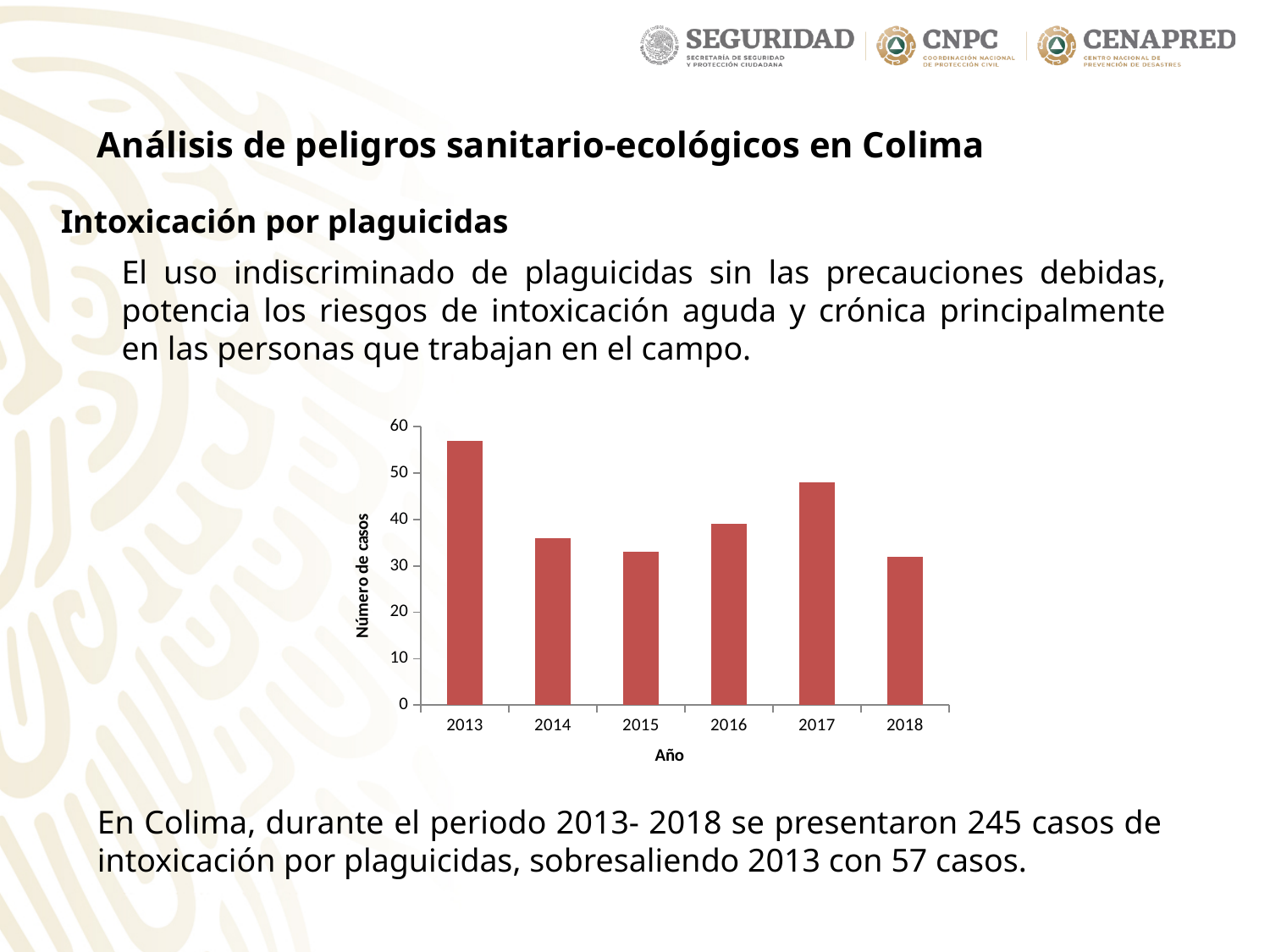
Which year has the highest number of cases in the chart? 2013 Is the value for 2017 greater or less than 40? greater Do the values rise or fall from 2015 to 2017? rise How many years are shown on the x axis of the chart? 6 According to the slide, how many cases of pesticide poisoning were there in 2013? 57 Is the value for 2017 greater or less than 50? less What is the label of the vertical axis of the chart? Número de casos What kind of chart is shown on the slide? bar chart Which year has the larger value, 2015 or 2016? 2016 Which year has the larger value, 2014 or 2017? 2017 Is the value for 2014 greater or less than 30? greater